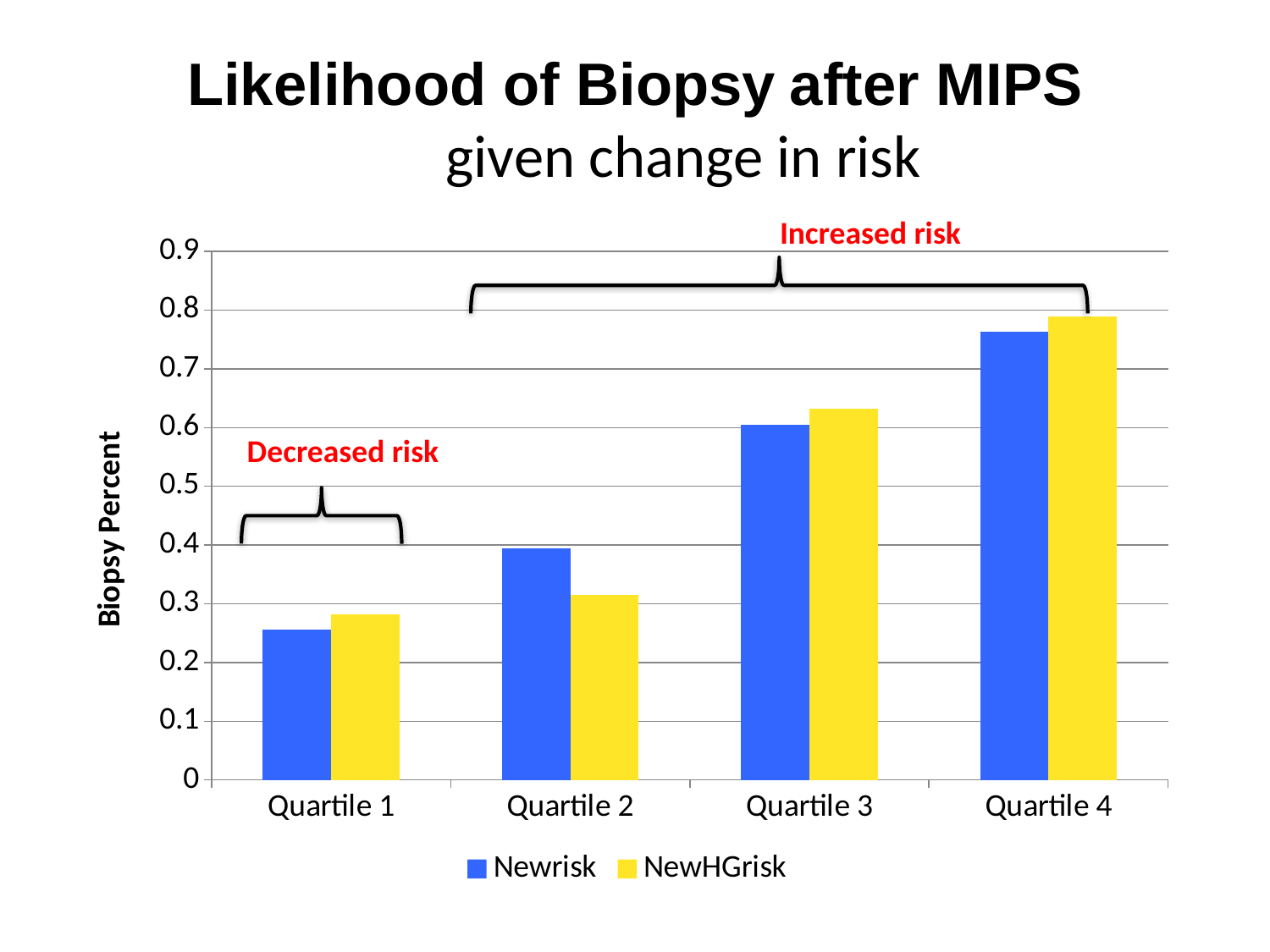
How many series does the legend list? 2 Which quartiles are grouped under the 'Increased risk' bracket? Quartile 2, Quartile 3 and Quartile 4 What kind of chart is shown on the slide? bar chart How many quartile categories are shown on the x axis? 4 Which quartile has the highest Newrisk value? Quartile 4 Is the Newrisk value for Quartile 1 greater or less than 0.3? less Do the Newrisk values rise or fall from Quartile 1 to Quartile 4? rise Is the NewHGrisk value for Quartile 3 greater or less than 0.6? greater Is the NewHGrisk value for Quartile 4 greater or less than 0.7? greater Which quartile has the lowest NewHGrisk value? Quartile 1 In Quartile 2, which series has the larger value, Newrisk or NewHGrisk? Newrisk What is the title of the y axis? Biopsy Percent